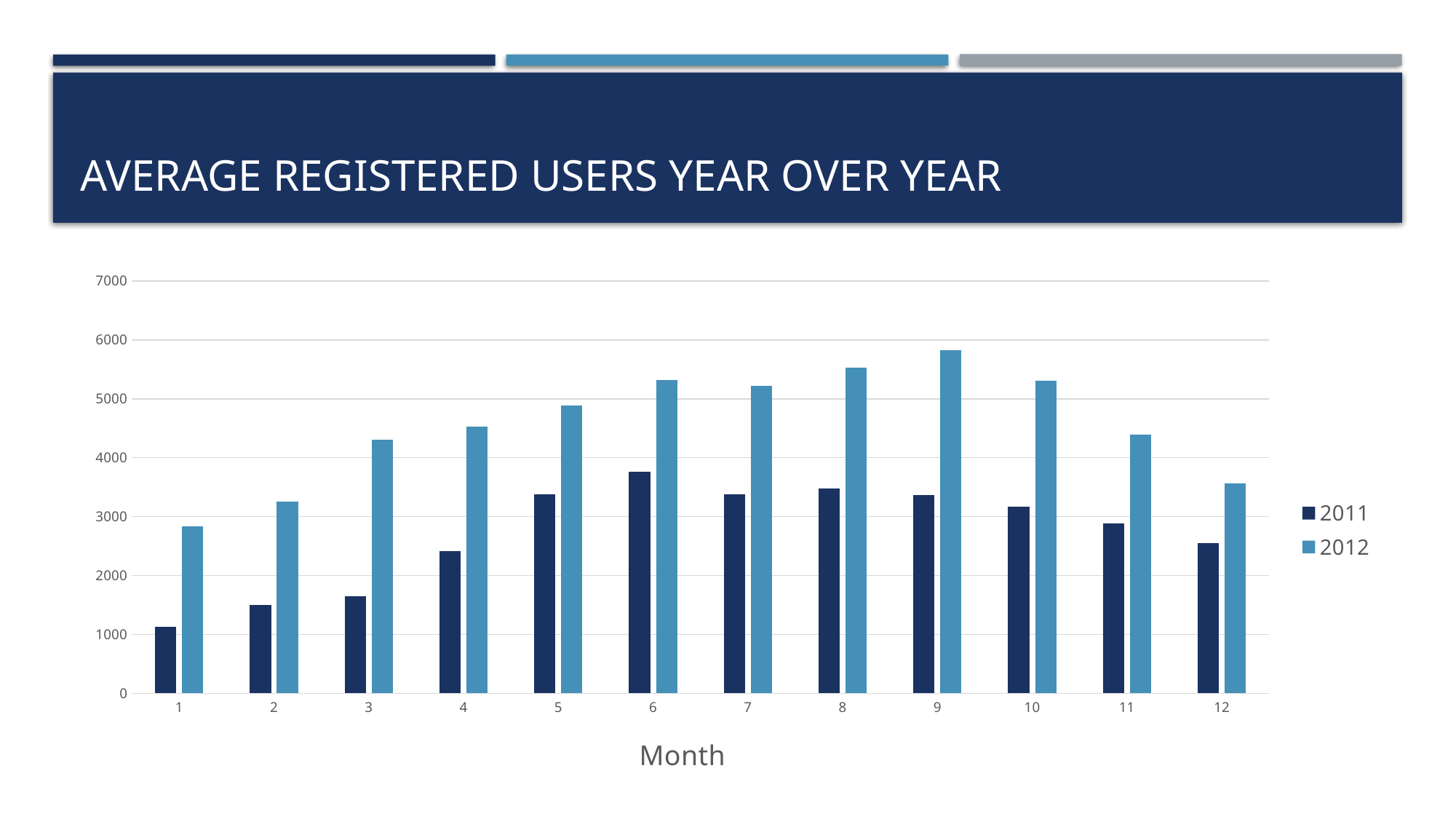
What is the title of the x axis? Month What kind of chart is shown on the slide? Bar chart Is the 2012 value for month 9 greater or less than 5000? greater In which month is the 2012 value lowest? 1 For month 6, which series has the larger value, 2011 or 2012? 2012 In which month is the 2011 value lowest? 1 In which month is the 2011 value highest? 6 How many months are shown on the x axis? 12 How many series does the legend list? 2 Is the 2012 value for month 3 greater or less than 4000? greater Is the 2011 value for month 12 greater or less than 3000? less In which month is the 2012 value highest? 9